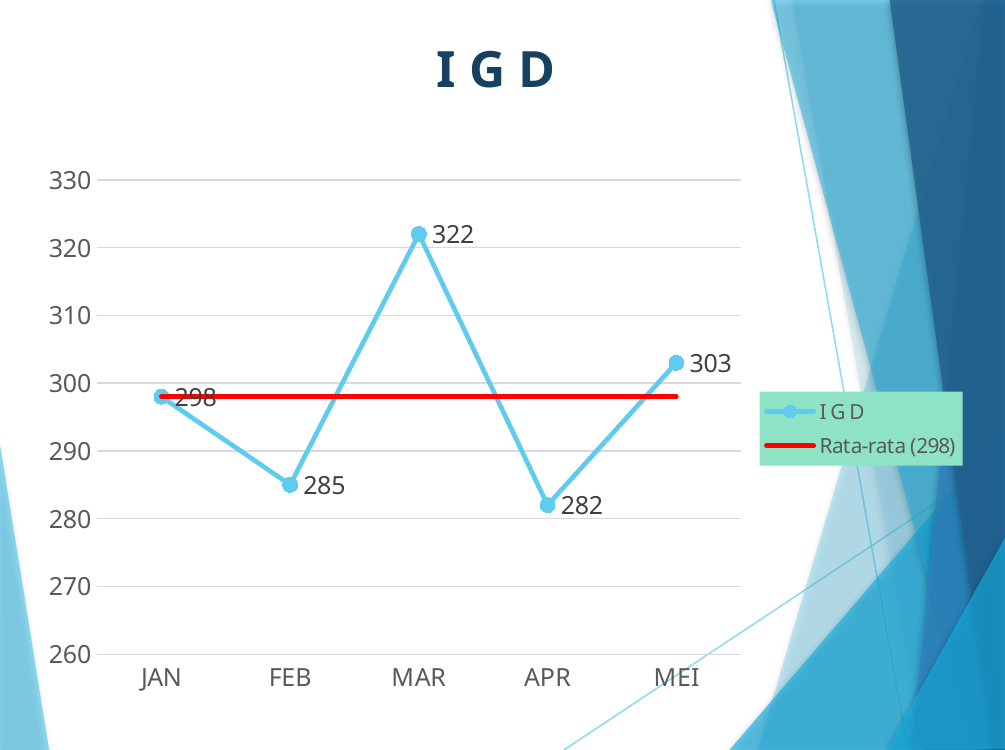
What value does the Rata-rata line represent according to the legend? 298 Which is larger, the I G D value for JAN or for MEI? MEI What is the difference between the I G D values for MAR and APR? 40 Which month has the highest I G D value? MAR Which month has the lowest I G D value? APR What kind of chart is shown? line chart How many months are plotted on the x axis? 5 Is the I G D value for APR greater or less than 290? less What is the I G D value for FEB? 285 What is the I G D value for MAR? 322 What is the I G D value for MEI? 303 How many series does the legend list? 2